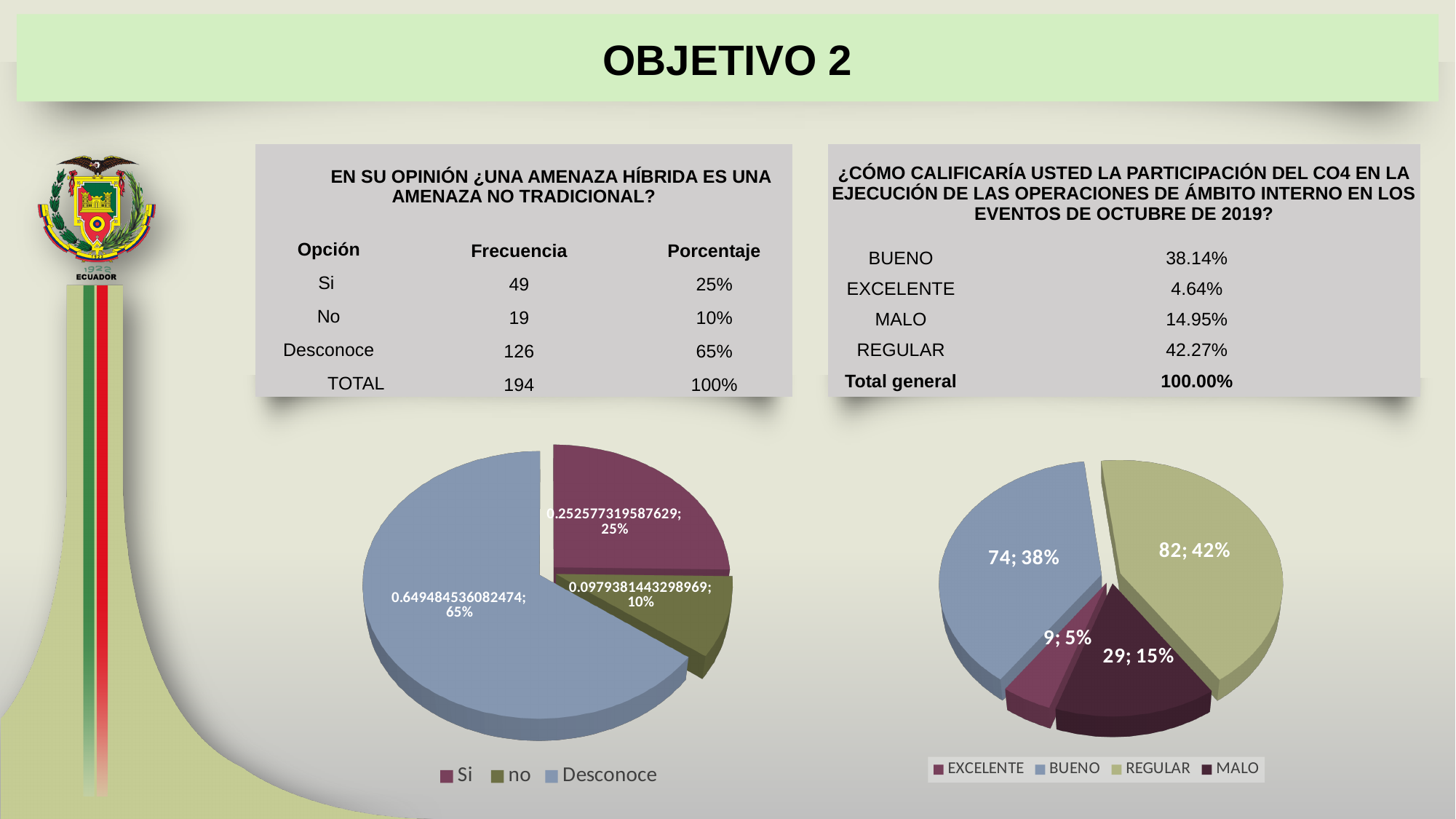
What type of chart is the left chart on the slide? pie chart In the right pie chart, which category has the largest slice? REGULAR In the left pie chart, what percentage is shown for the Si slice? 25% How many categories does the legend of the right pie chart list? 4 In the right pie chart, which category has the smallest slice? EXCELENTE In the right pie chart, what value and percentage are labelled on the EXCELENTE slice? 9; 5% In the left pie chart, which category has the smallest slice? no In the right pie chart, what is the difference between the BUENO count and the MALO count? 45 In the left pie chart, what percentage is shown for the Desconoce slice? 65% In the right pie chart, what value and percentage are labelled on the REGULAR slice? 82; 42% How many categories does the legend of the left pie chart list? 3 In the right pie chart, which slice is larger, BUENO or MALO? BUENO